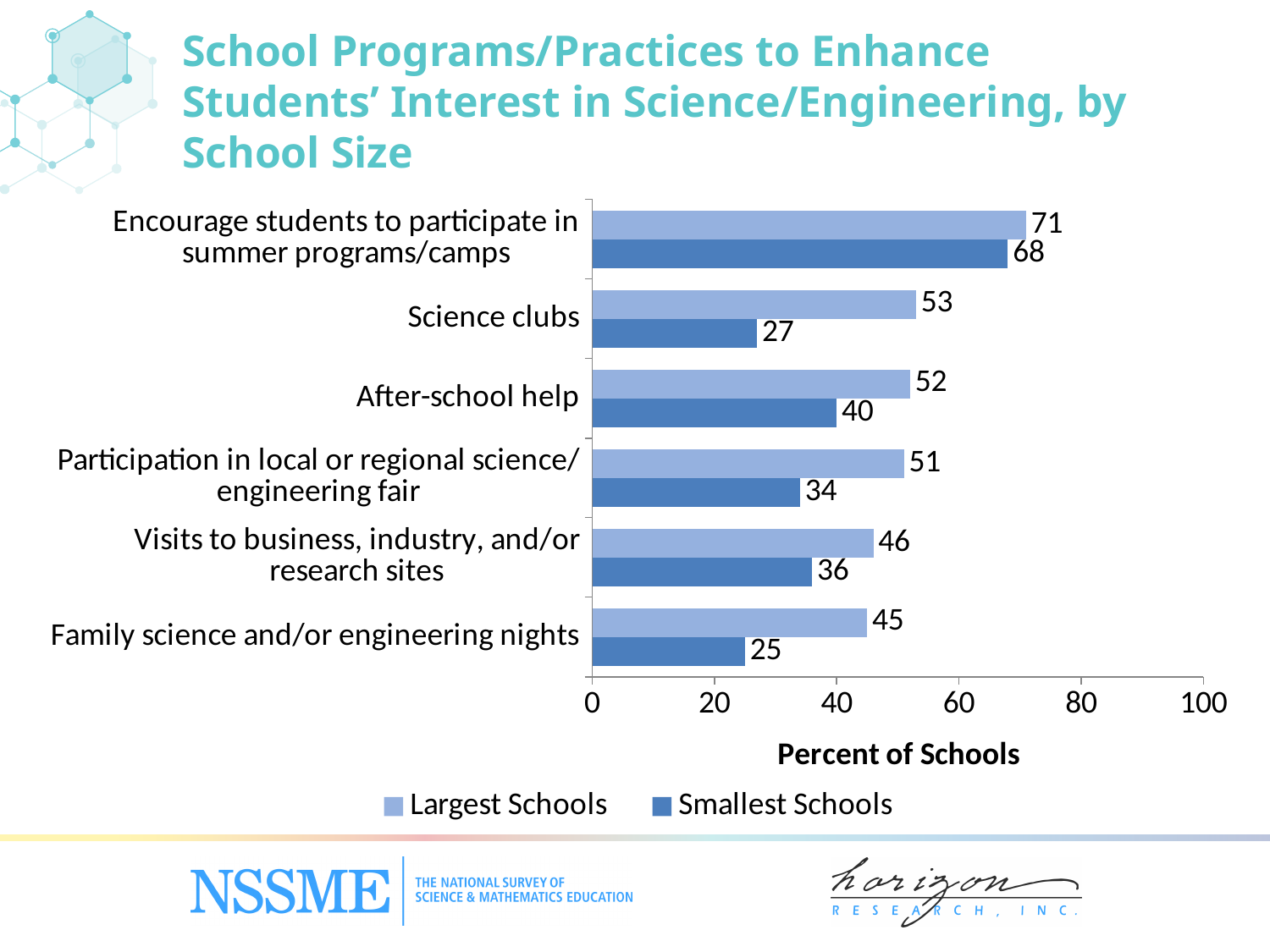
Which is larger: the Smallest Schools value for visits to business, industry, and/or research sites or the Smallest Schools value for participation in local or regional science/engineering fair? Visits to business, industry, and/or research sites How many programs/practices are shown on the chart? 6 Which program/practice has the highest value for Largest Schools? Encourage students to participate in summer programs/camps What percent of the smallest schools have science clubs? 27 What kind of chart is shown on the slide? Bar chart Which program/practice has the lowest value for Smallest Schools? Family science and/or engineering nights What is the difference between Largest Schools and Smallest Schools for science clubs? 26 What is the difference between Largest Schools and Smallest Schools for family science and/or engineering nights? 20 What percent of the largest schools encourage students to participate in summer programs/camps? 71 What is the value for Smallest Schools for after-school help? 40 How many series does the legend list? 2 What is the label of the horizontal axis? Percent of Schools